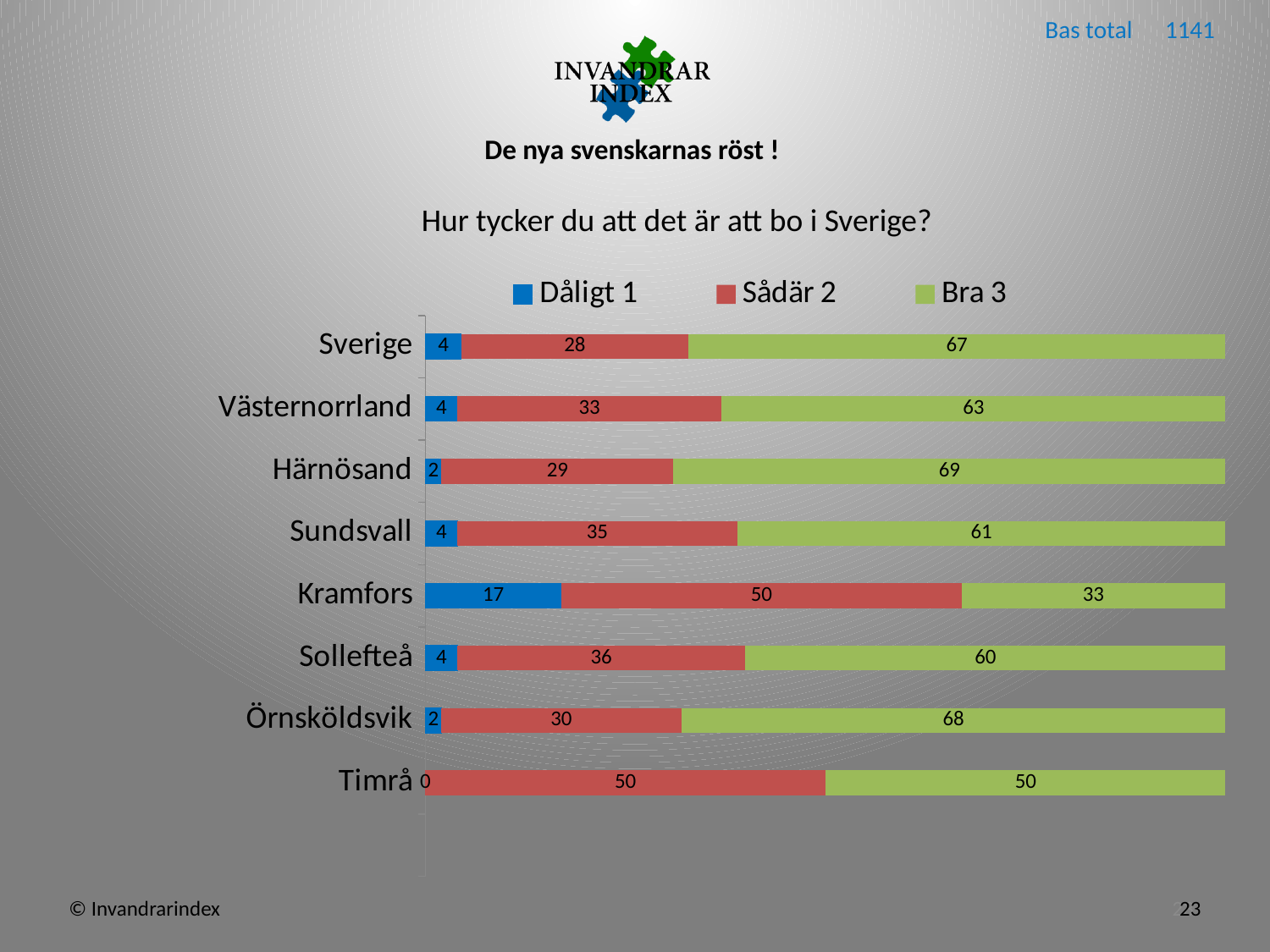
How many categories are shown on the chart? 8 What is the title of the chart? Hur tycker du att det är att bo i Sverige? How many series does the legend list? 3 What is the value of 'Sådär 2' for Kramfors? 50 What kind of chart is shown on the slide? Stacked bar chart What is the difference between the 'Bra 3' values for Sverige and Västernorrland? 4 Which category has the lowest value for 'Bra 3'? Kramfors What is the total of the stacked bar for Örnsköldsvik? 100 What is the value of 'Dåligt 1' for Timrå? 0 Which category has the highest value for 'Dåligt 1'? Kramfors Which is larger: the 'Sådär 2' value for Sundsvall or for Sollefteå? Sollefteå What is the value of 'Bra 3' for Härnösand? 69